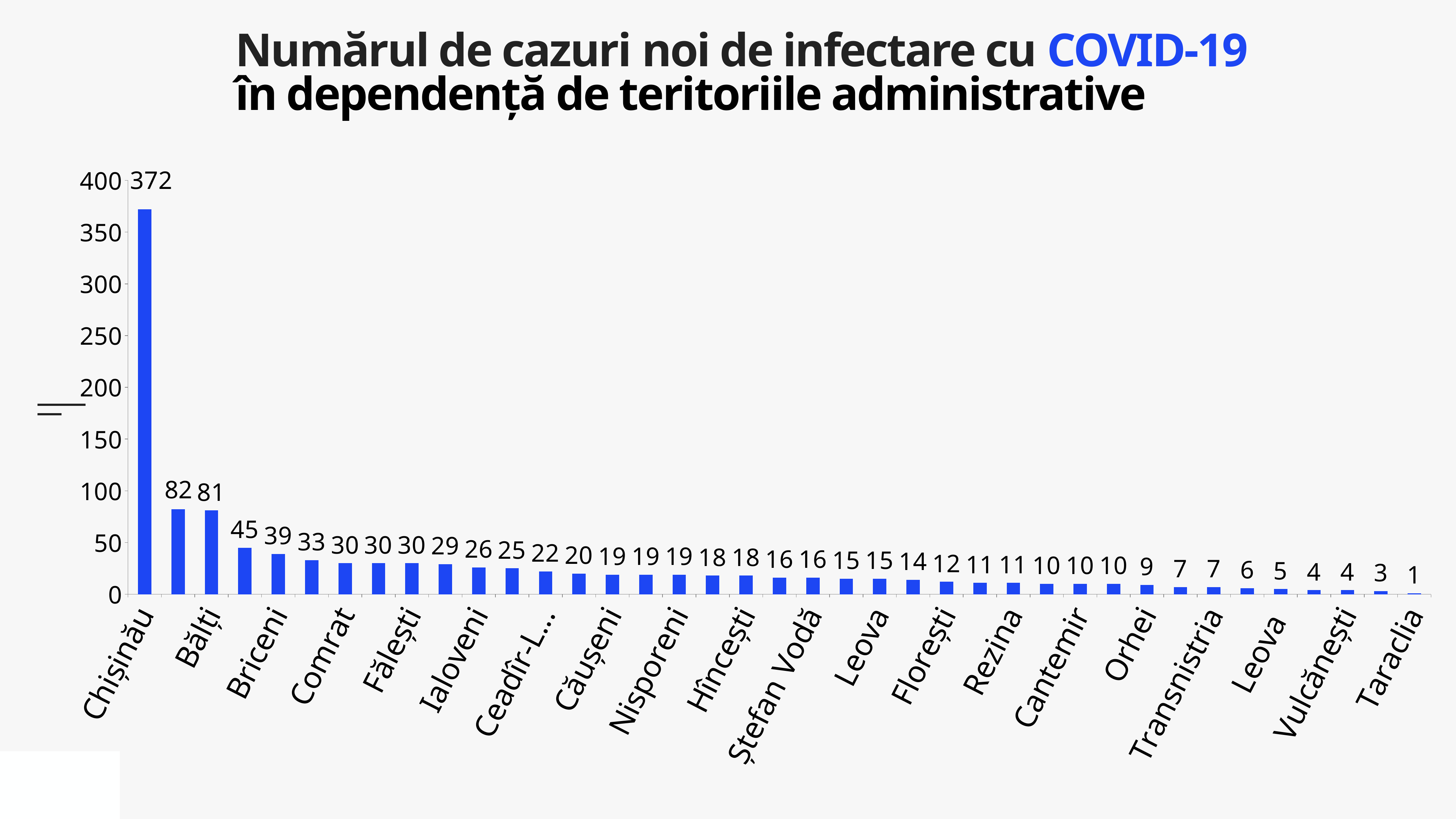
What is the difference between the values for Chișinău and Taraclia? 371 Which has a larger value, Briceni or Ialoveni? Briceni Which territory has the lowest number of new cases? Taraclia What is the value shown for Briceni? 39 Which territory has the highest number of new cases? Chișinău What is the value shown for Transnistria? 7 Do the values rise or fall moving from left to right along the x axis? fall What is the number of new COVID-19 cases for Chișinău? 372 What is the value shown for Taraclia? 1 What type of chart is shown on the slide? bar chart What is the value shown for Ialoveni? 26 Is the value for Chișinău greater or less than 350? greater